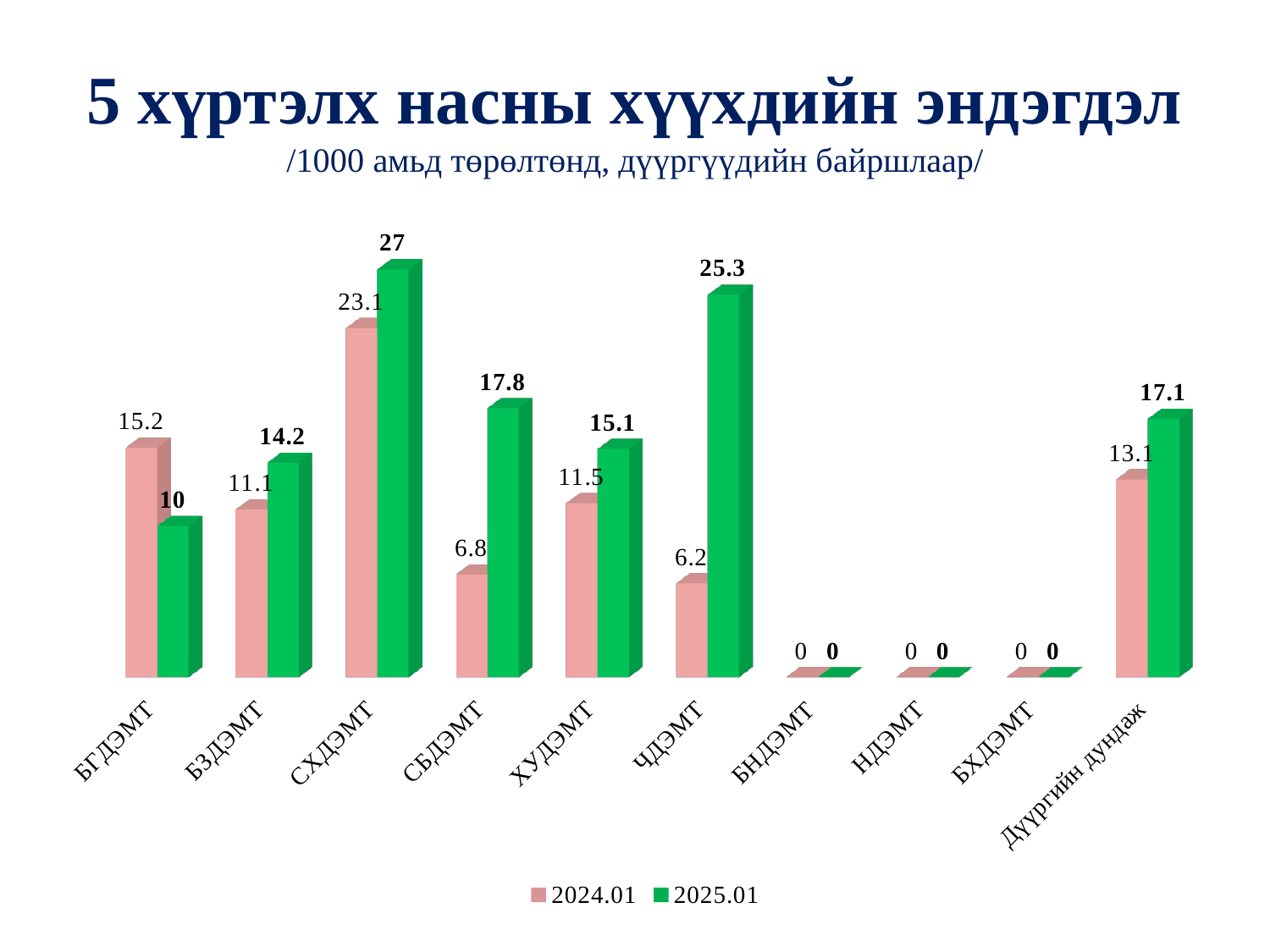
Which category has the highest 2025.01 value? СХДЭМТ Which colour represents the 2025.01 series? Green How many series does the legend list? 2 How many categories have a value of 0 for both series? 3 What is the difference between the 2025.01 and 2024.01 values for ЧДЭМТ? 19.1 What is the 2025.01 value for СХДЭМТ? 27 What is the 2025.01 value for Дүүргийн дундаж? 17.1 How many categories are shown on the x axis? 10 Which is larger for БГДЭМТ, the 2024.01 value or the 2025.01 value? 2024.01 What kind of chart is shown on the slide? Bar chart What is the 2024.01 value for ЧДЭМТ? 6.2 Among the categories with non-zero values, which has the lowest 2024.01 value? ЧДЭМТ